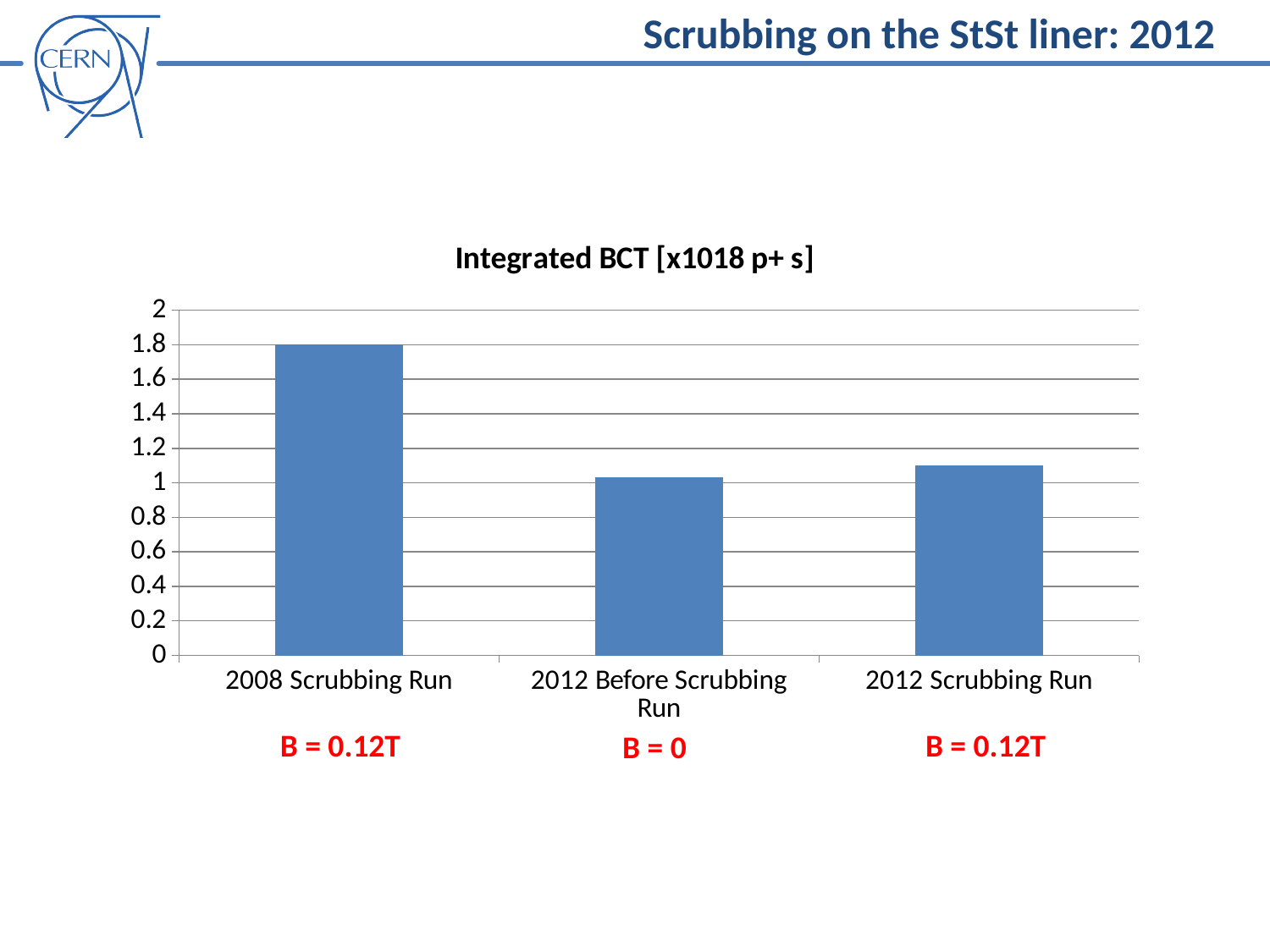
Is the value for 2012 Before Scrubbing Run greater or less than 1.2? less Is the value for 2008 Scrubbing Run greater or less than 1.6? greater Is the value for 2012 Scrubbing Run greater or less than 1? greater What kind of chart is shown on the slide? bar chart Which is larger, the value for 2008 Scrubbing Run or the value for 2012 Scrubbing Run? 2008 Scrubbing Run Which category has the lowest Integrated BCT value? 2012 Before Scrubbing Run Which category has the highest Integrated BCT value? 2008 Scrubbing Run What is the title of the chart? Integrated BCT [x1018 p+ s] How many categories are plotted in the chart? 3 Which category is annotated with B = 0 below the chart? 2012 Before Scrubbing Run What is the Integrated BCT value for the 2008 Scrubbing Run? 1.8